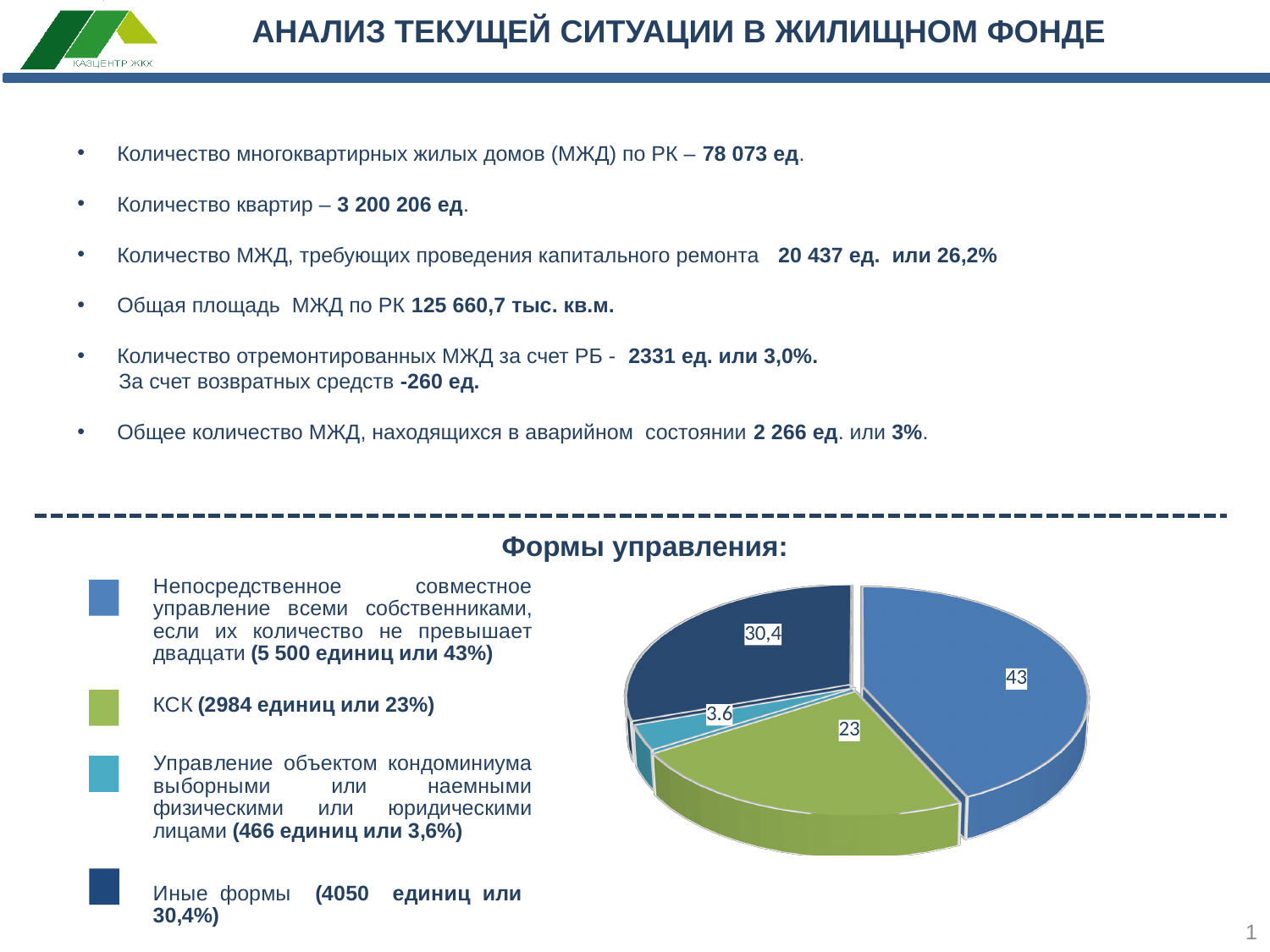
What value is shown on the pie slice for КСК? 23 What is the difference between the largest slice (43) and the КСК slice (23) in the pie chart? 20 Which form of management has the smallest slice in the pie chart? Управление объектом кондоминиума выборными или наемными физическими или юридическими лицами How many slices does the "Формы управления:" pie chart have? 4 What value is shown on the smallest slice of the pie chart? 3.6 Which slice is larger in the pie chart: КСК or Иные формы? Иные формы What value is shown on the pie slice for Иные формы? 30,4 What colour is the КСК slice in the pie chart? green What share of the pie does КСК represent? 23% What is the value of the largest slice in the "Формы управления:" pie chart? 43 What kind of chart is shown under "Формы управления:"? pie chart What is the title above the pie chart? Формы управления: